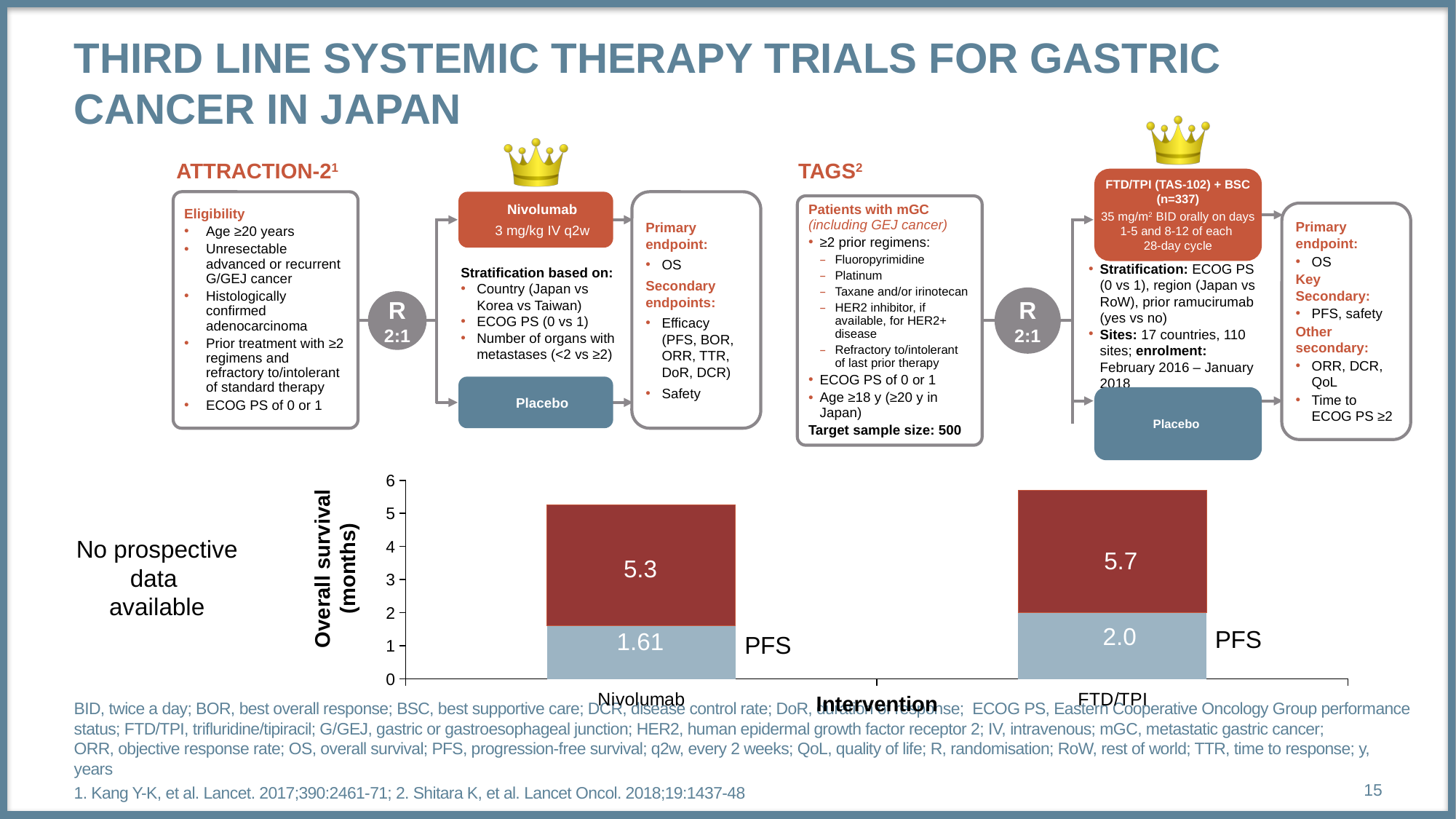
Which intervention has the lower PFS value? Nivolumab What PFS value is shown for FTD/TPI? 2.0 Which intervention has the higher overall survival value? FTD/TPI What is the difference between the overall survival values for FTD/TPI and Nivolumab? 0.4 What is the overall survival value shown for FTD/TPI? 5.7 What PFS value is shown for Nivolumab? 1.61 How many interventions are plotted on the x axis of the chart? 2 What is the label of the x axis of the chart? Intervention What is the overall survival value shown for Nivolumab? 5.3 Is the PFS value for Nivolumab larger or smaller than the PFS value for FTD/TPI? smaller What is the label of the y axis of the chart? Overall survival (months) What kind of chart is used to show overall survival? bar chart